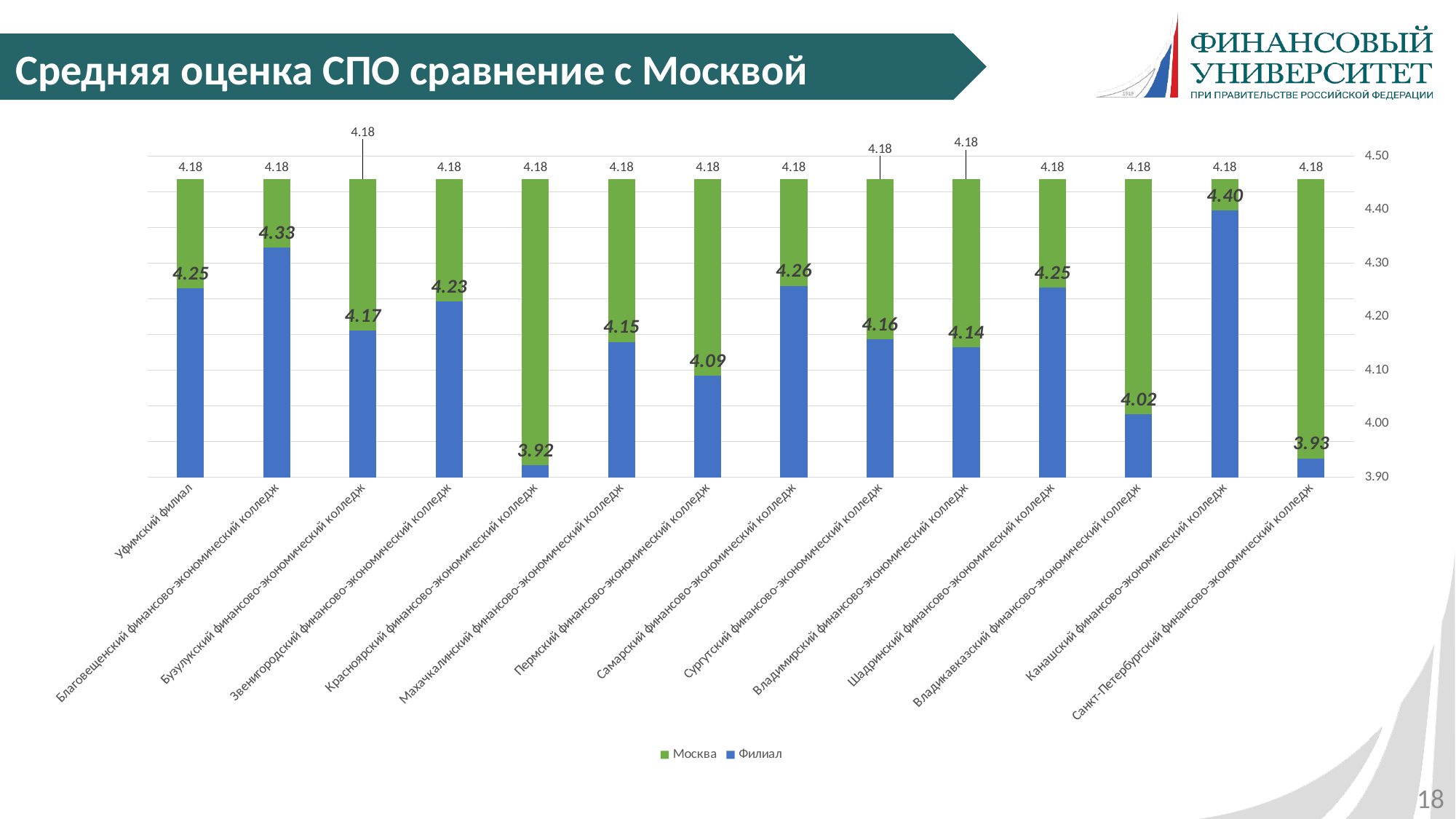
What is the Филиал value for Канашский финансово-экономический колледж? 4.40 Which category has the highest Филиал value? Канашский финансово-экономический колледж How many categories are shown on the x axis? 14 What is the difference between the Филиал value for Канашский финансово-экономический колледж and the Москва value of 4.18? 0.22 What kind of chart is shown on the slide? bar chart What is the Филиал value for Красноярский финансово-экономический колледж? 3.92 Is the Филиал value for Владикавказский финансово-экономический колледж greater or less than 4.10? less What is the Москва value shown for Уфимский филиал? 4.18 Which is larger: the Филиал value for Благовещенский финансово-экономический колледж or for Уфимский филиал? Благовещенский финансово-экономический колледж What is the Филиал value for Пермский финансово-экономический колледж? 4.09 How many series does the legend list? 2 Which category has the lowest Филиал value? Красноярский финансово-экономический колледж